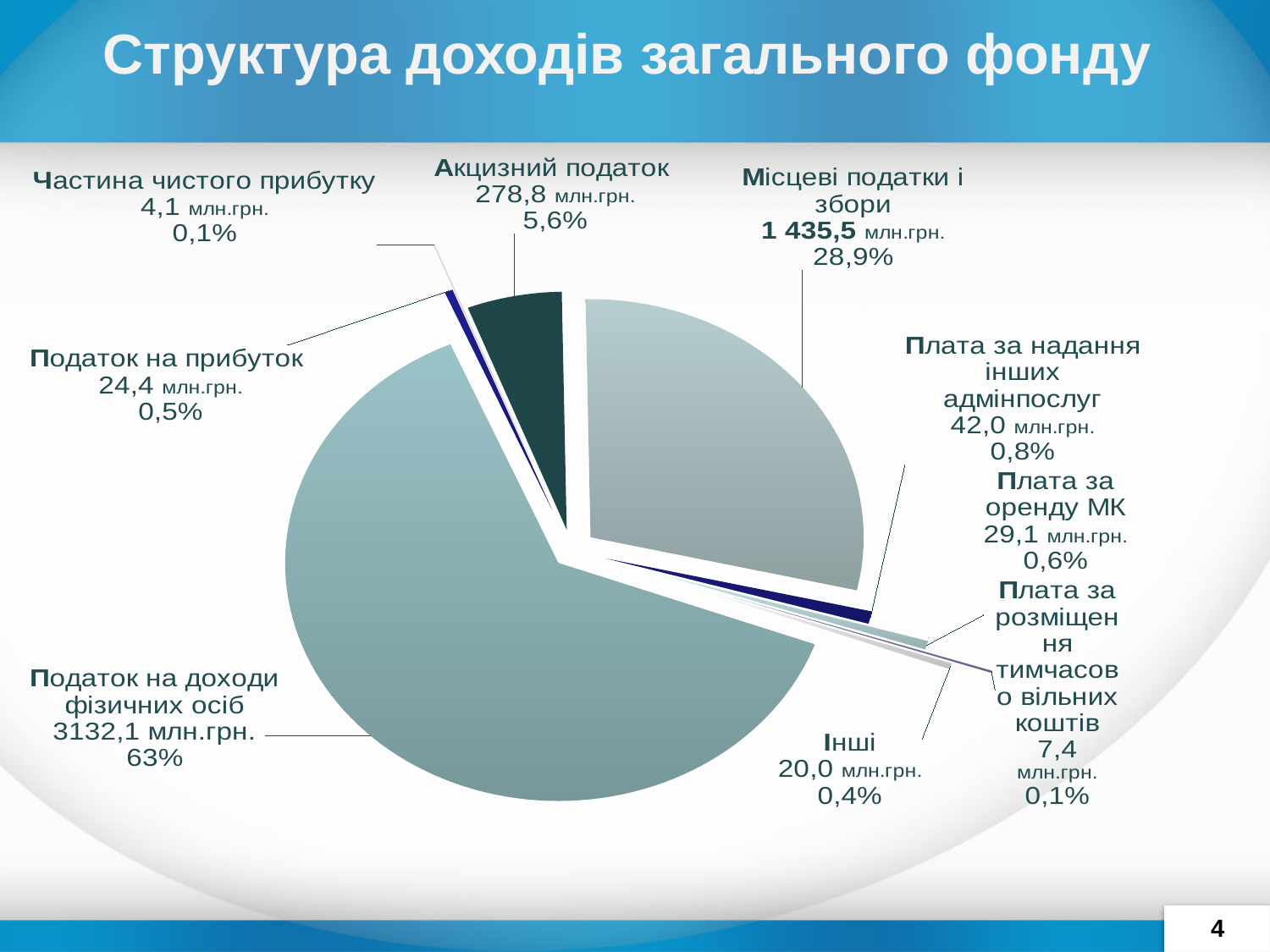
What is the value for Податок на доходи фізичних осіб? 3132,1 млн.грн. Which category has the largest slice of the pie? Податок на доходи фізичних осіб What share of the pie does Місцеві податки і збори represent? 28,9% What share of the pie does Частина чистого прибутку represent? 0,1% What is the value for Акцизний податок? 278,8 млн.грн. What is the difference in value between Місцеві податки і збори and Акцизний податок? 1 156,7 млн.грн. How many slices does the pie chart have? 9 What is the value for Плата за оренду МК? 29,1 млн.грн. What is the title of the chart? Структура доходів загального фонду Which is larger, Плата за надання інших адмінпослуг or Інші? Плата за надання інших адмінпослуг What type of chart is shown on the slide? pie chart What share of the pie does Податок на доходи фізичних осіб represent? 63%